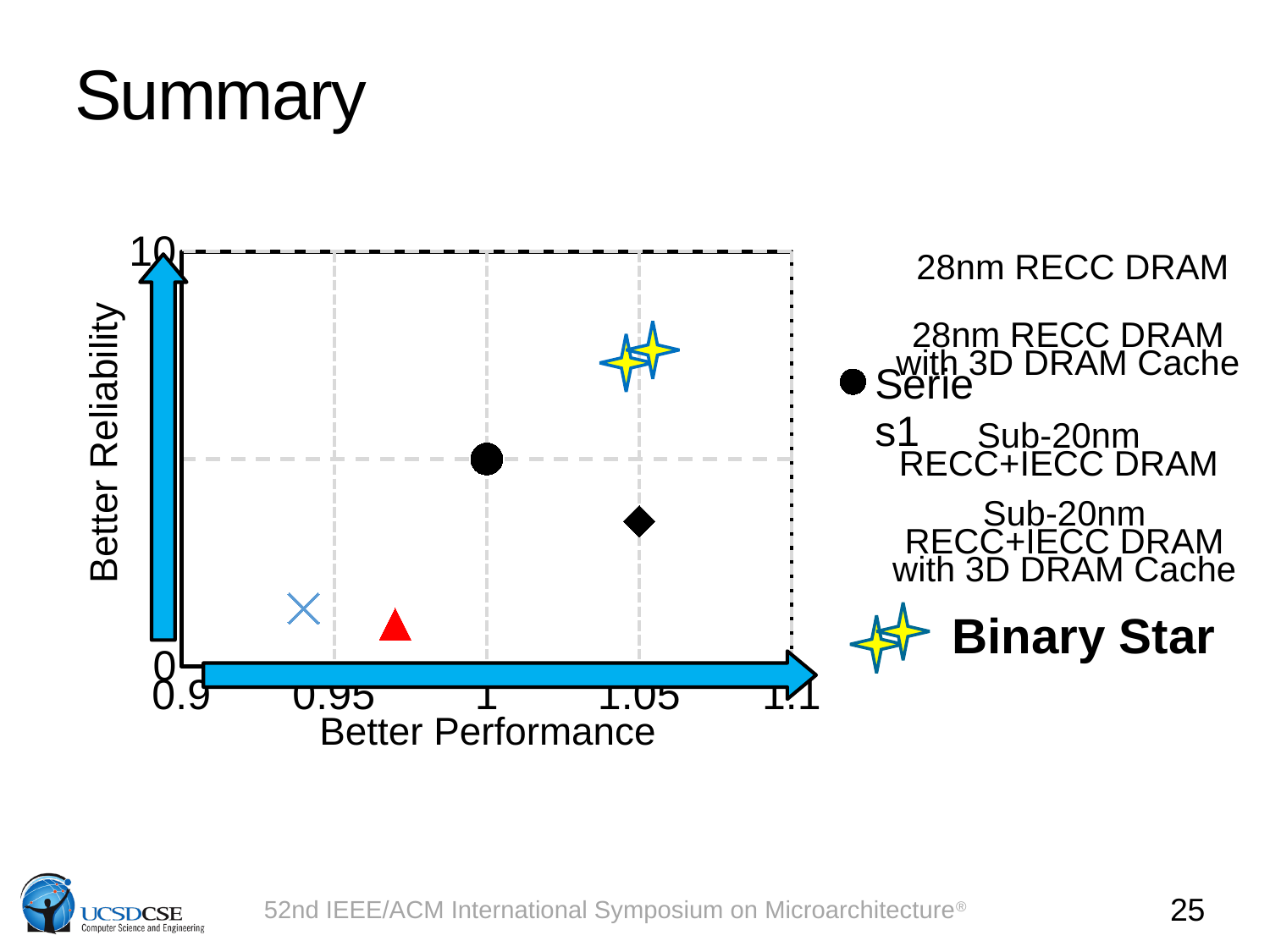
Which has the higher reliability, the black circle marker or the black diamond marker? the black circle marker Is the performance value for the red triangle marker greater or less than 0.95? greater How many data points are plotted on the chart? 5 What is the performance (x value) of the black circle marker? 1 Which has the higher performance, the blue x marker or the red triangle marker? the red triangle marker Which plotted point has the lowest performance (x value)? the blue x marker Is the performance value for the blue x marker greater or less than 0.95? less What is the label of the y axis? Better Reliability Which plotted point has the highest reliability (y value)? Binary Star (the star marker) Is the performance value for Binary Star greater or less than 1? greater What is the label of the x axis? Better Performance What kind of chart is shown on the slide? scatter chart